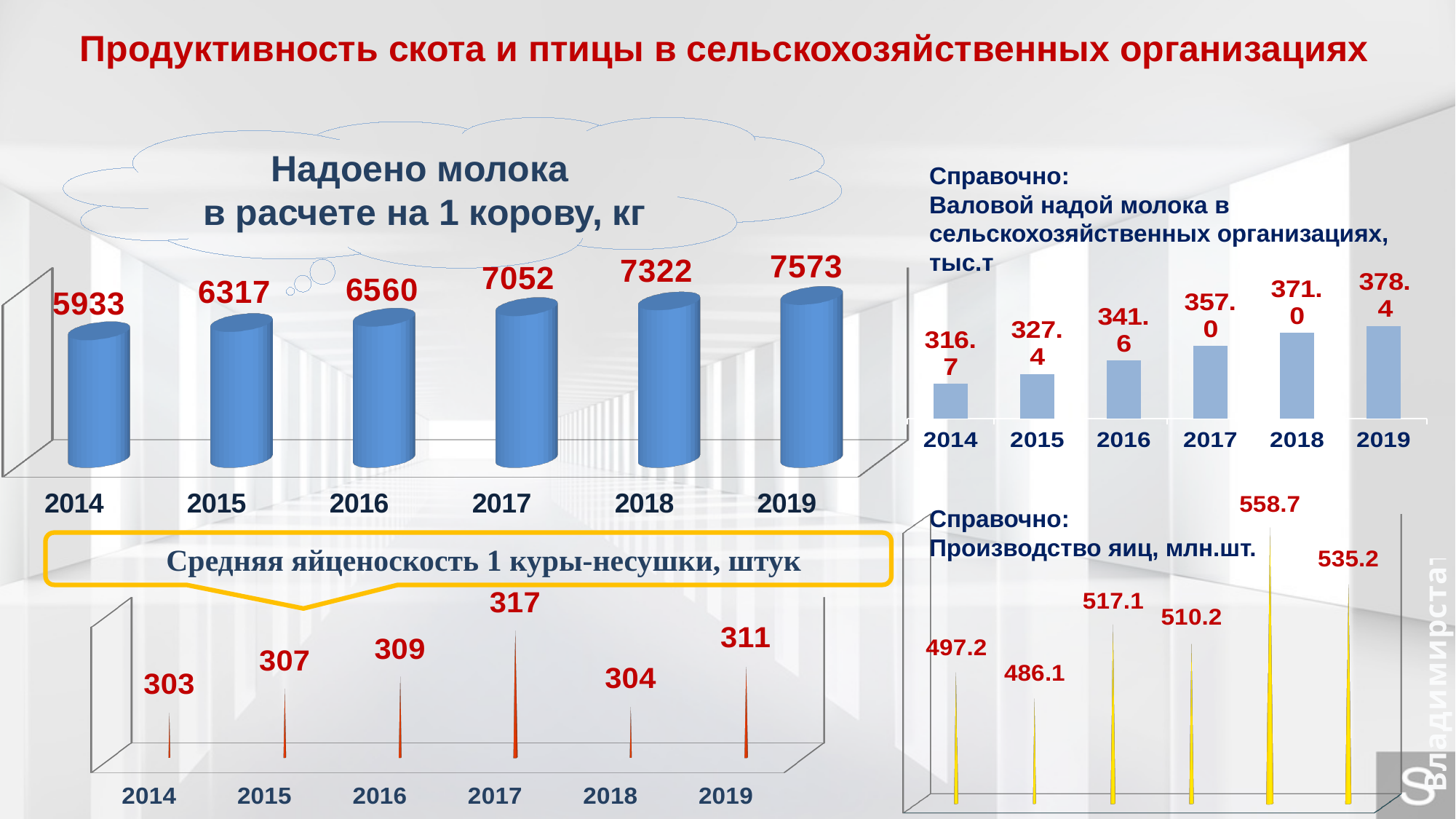
In the chart 'Надоено молока в расчете на 1 корову, кг', do the values rise or fall from 2014 to 2019? rise In the chart 'Производство яиц, млн.шт.', what is the highest value shown? 558.7 In the chart 'Валовой надой молока в сельскохозяйственных организациях, тыс.т', how many years are shown? 6 What type of chart is 'Надоено молока в расчете на 1 корову, кг'? bar chart In the chart 'Валовой надой молока в сельскохозяйственных организациях, тыс.т', which year has the highest value? 2019 In the chart 'Средняя яйценоскость 1 куры-несушки, штук', which year has the lowest value? 2014 In the chart 'Надоено молока в расчете на 1 корову, кг', which year has the lowest value? 2014 In the chart 'Средняя яйценоскость 1 куры-несушки, штук', which is larger, the value for 2018 or the value for 2019? 2019 In the chart 'Надоено молока в расчете на 1 корову, кг', what is the difference between the 2019 and 2014 values? 1640 In the chart 'Валовой надой молока в сельскохозяйственных организациях, тыс.т', what is the value for 2017? 357.0 In the chart 'Средняя яйценоскость 1 куры-несушки, штук', what is the value for 2017? 317 In the chart 'Надоено молока в расчете на 1 корову, кг', what is the value for 2019? 7573